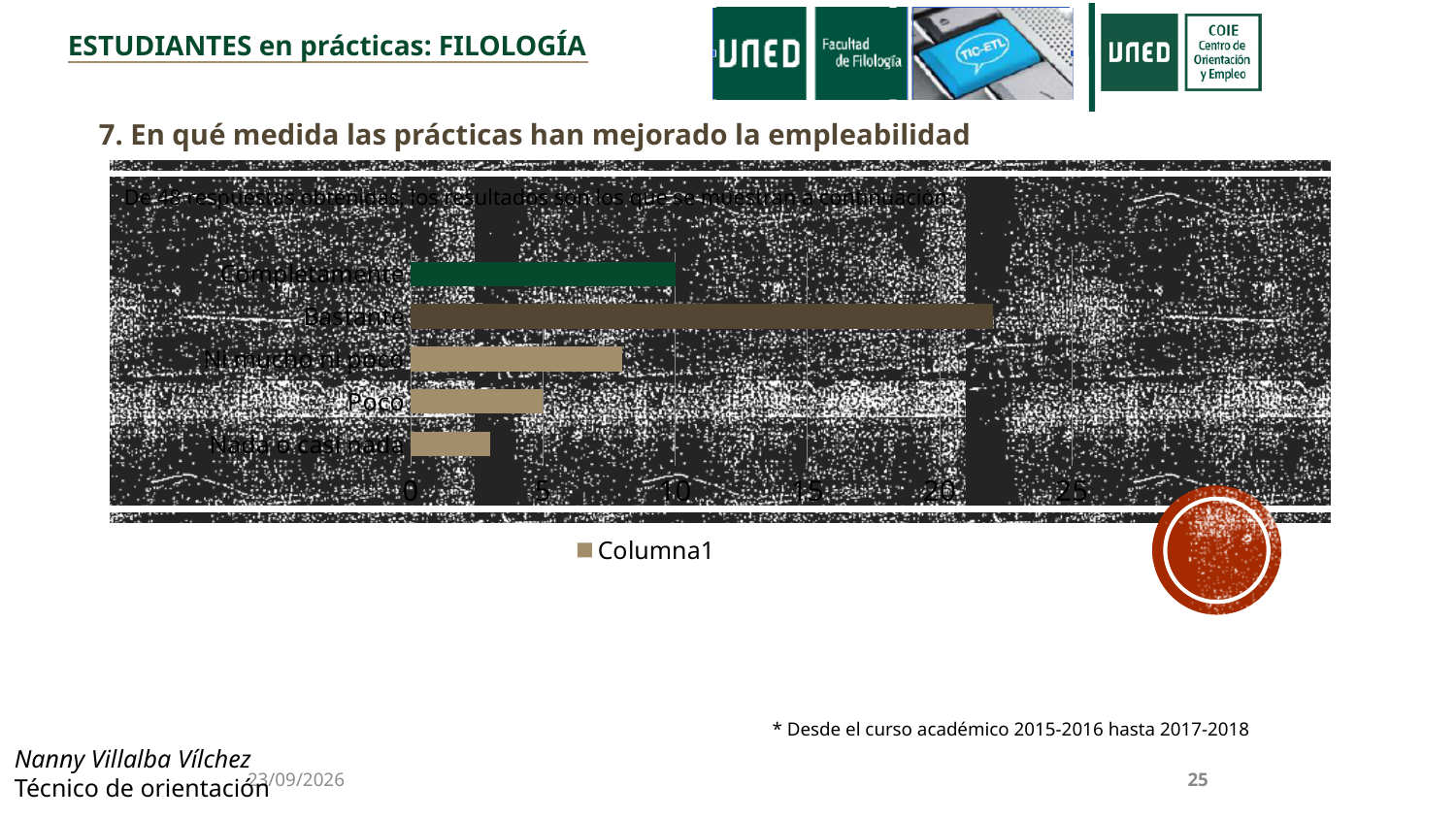
Is the value for Completamente greater or less than 5? greater Which category has the highest value in the chart? Bastante What is the name of the series shown in the chart legend? Columna1 Which category has the lowest value in the chart? Nada o casi nada Which category's bar is coloured dark green rather than brown? Completamente Is the value for Nada o casi nada greater or less than 5? less How many series does the chart legend list? 1 How many categories are plotted in the chart? 5 Which is larger, the value for Bastante or the value for Completamente? Bastante What kind of chart is shown on the slide? bar chart Is the value for Ni mucho ni poco greater or less than 10? less